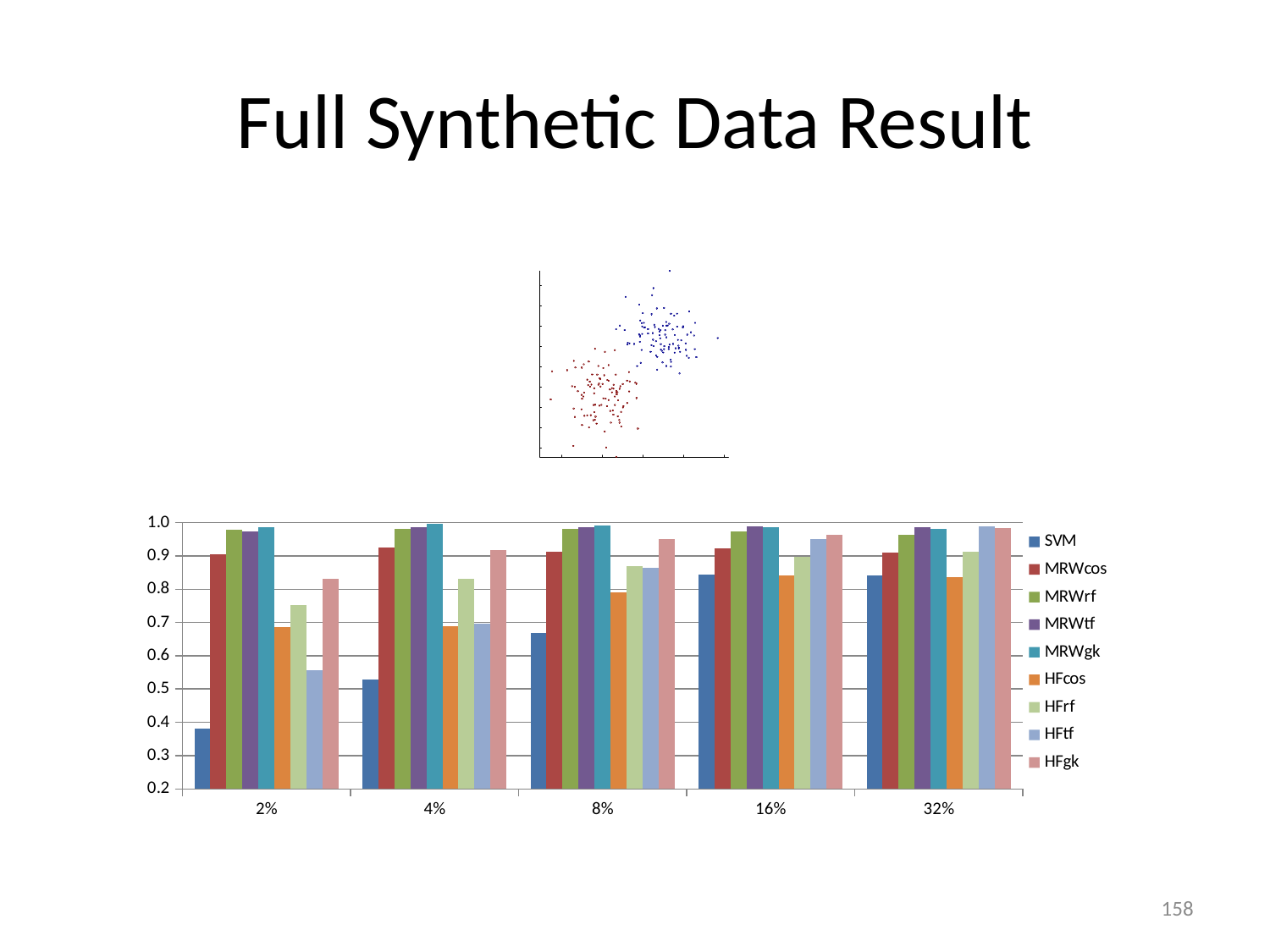
In the bar chart, is the value for SVM at 4% greater or less than 0.5? greater In the bar chart, is the value for SVM at 2% greater or less than 0.4? less In the bar chart, which is larger at 2%: HFrf or HFtf? HFrf In the bar chart, is the value for HFtf at 2% greater or less than 0.5? greater In the bar chart, do the SVM values rise or fall as the x axis goes from 2% to 32%? rise In the bar chart, which series is listed first in the legend? SVM In the bar chart, which series has the lowest value at 2%? SVM In the bar chart, which is larger at 2%: SVM or MRWcos? MRWcos In the bar chart, how many categories are shown on the x axis? 5 In the bar chart, how many series does the legend list? 9 What kind of chart is the chart at the bottom of the slide? bar chart